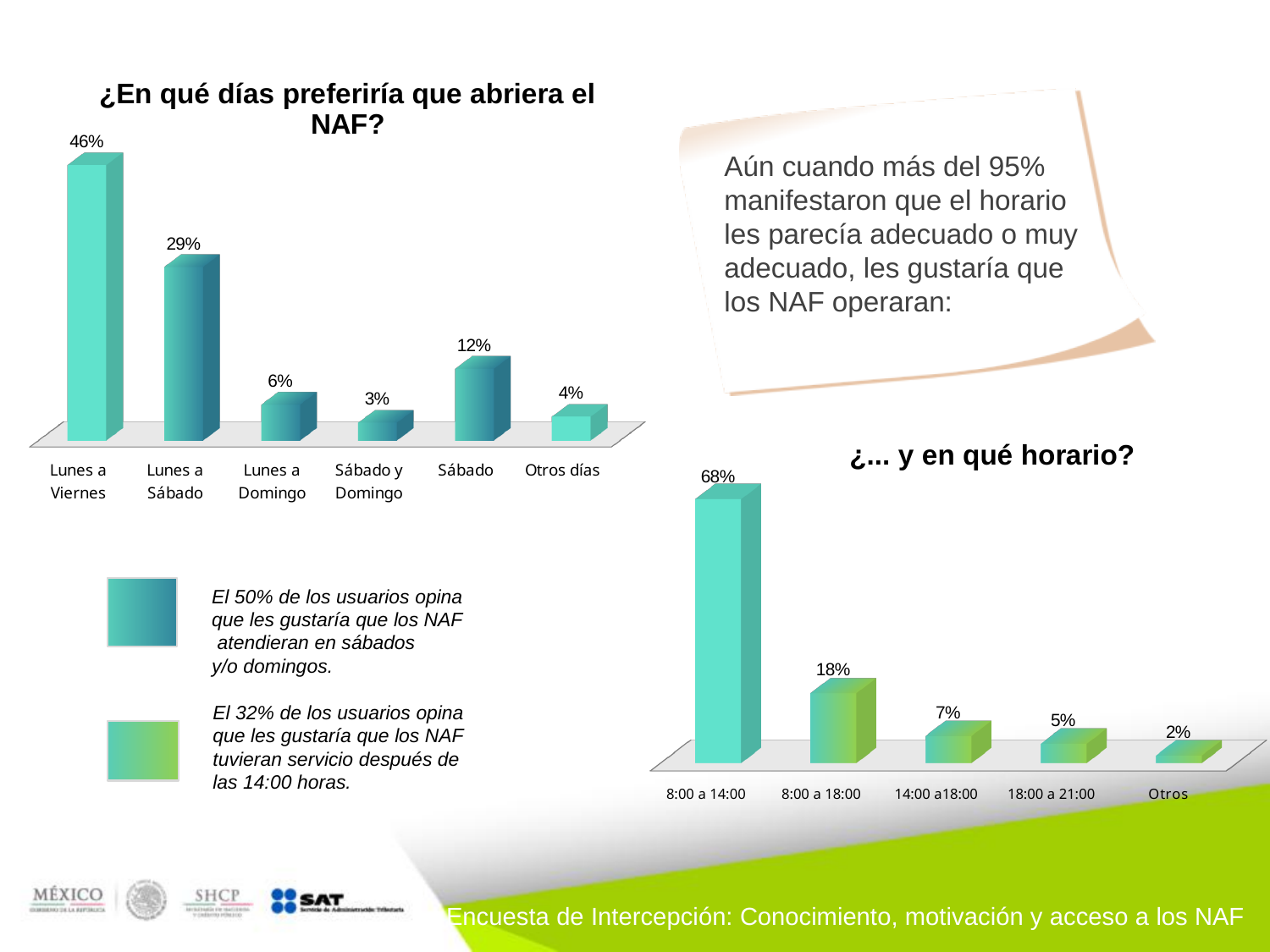
In the chart titled "¿... y en qué horario?", which category has the highest value? 8:00 a 14:00 In the chart titled "¿En qué días preferiría que abriera el NAF?", which is larger, Lunes a Domingo or Otros días? Lunes a Domingo In the chart titled "¿En qué días preferiría que abriera el NAF?", how many categories are shown? 6 In the chart titled "¿... y en qué horario?", what is the value for 14:00 a 18:00? 7% In the chart titled "¿En qué días preferiría que abriera el NAF?", what is the difference between Lunes a Viernes and Lunes a Sábado? 17% In the chart titled "¿En qué días preferiría que abriera el NAF?", what is the value for Sábado? 12% In the chart titled "¿... y en qué horario?", what is the value for 8:00 a 14:00? 68% In the chart titled "¿En qué días preferiría que abriera el NAF?", which category has the lowest value? Sábado y Domingo In the chart titled "¿... y en qué horario?", how many categories are shown? 5 In the chart titled "¿En qué días preferiría que abriera el NAF?", what is the value for Lunes a Viernes? 46% What kind of chart is the one titled "¿... y en qué horario?"? Bar chart In the chart titled "¿... y en qué horario?", what is the difference between 8:00 a 18:00 and 18:00 a 21:00? 13%